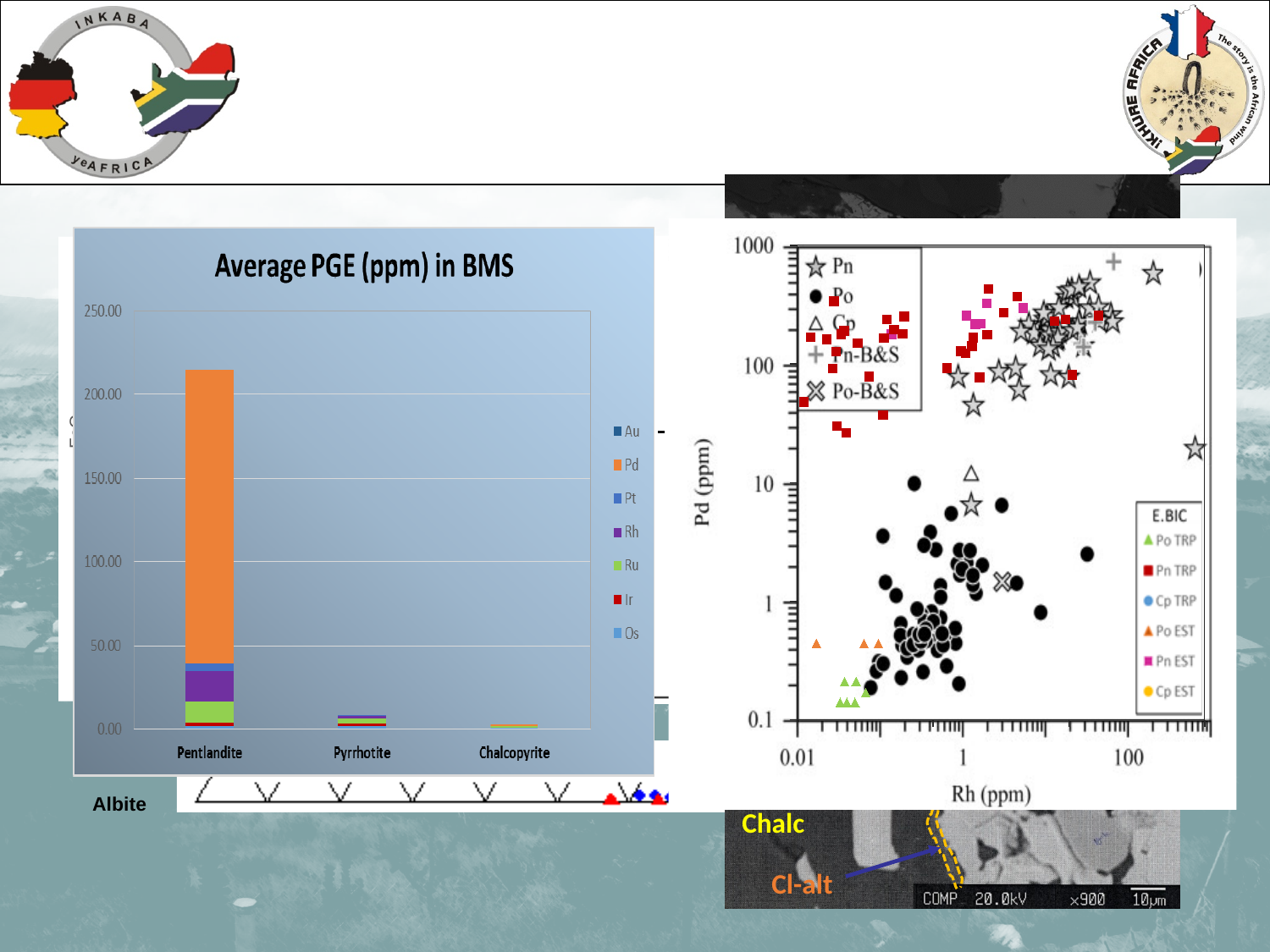
What is the title of the bar chart on the left of the slide? Average PGE (ppm) in BMS What kind of chart is the 'Average PGE (ppm) in BMS' chart? stacked bar chart In the 'Average PGE (ppm) in BMS' chart, which mineral has the highest total PGE value? Pentlandite In the 'Average PGE (ppm) in BMS' chart, is the total value for Pentlandite greater or less than 200.00? greater In the 'Average PGE (ppm) in BMS' chart, which element makes up the largest part of the Pentlandite bar? Pd In the 'Average PGE (ppm) in BMS' chart, which is larger, the total for Pentlandite or the total for Chalcopyrite? Pentlandite What is the y-axis label of the scatter plot on the right of the slide? Pd (ppm) How many series does the legend of the 'Average PGE (ppm) in BMS' chart list? 7 In the 'Average PGE (ppm) in BMS' chart, is the total value for Pyrrhotite greater or less than 50.00? less How many mineral categories are shown on the x axis of the 'Average PGE (ppm) in BMS' chart? 3 What kind of chart is the chart on the right of the slide with Rh (ppm) on the x axis? scatter plot